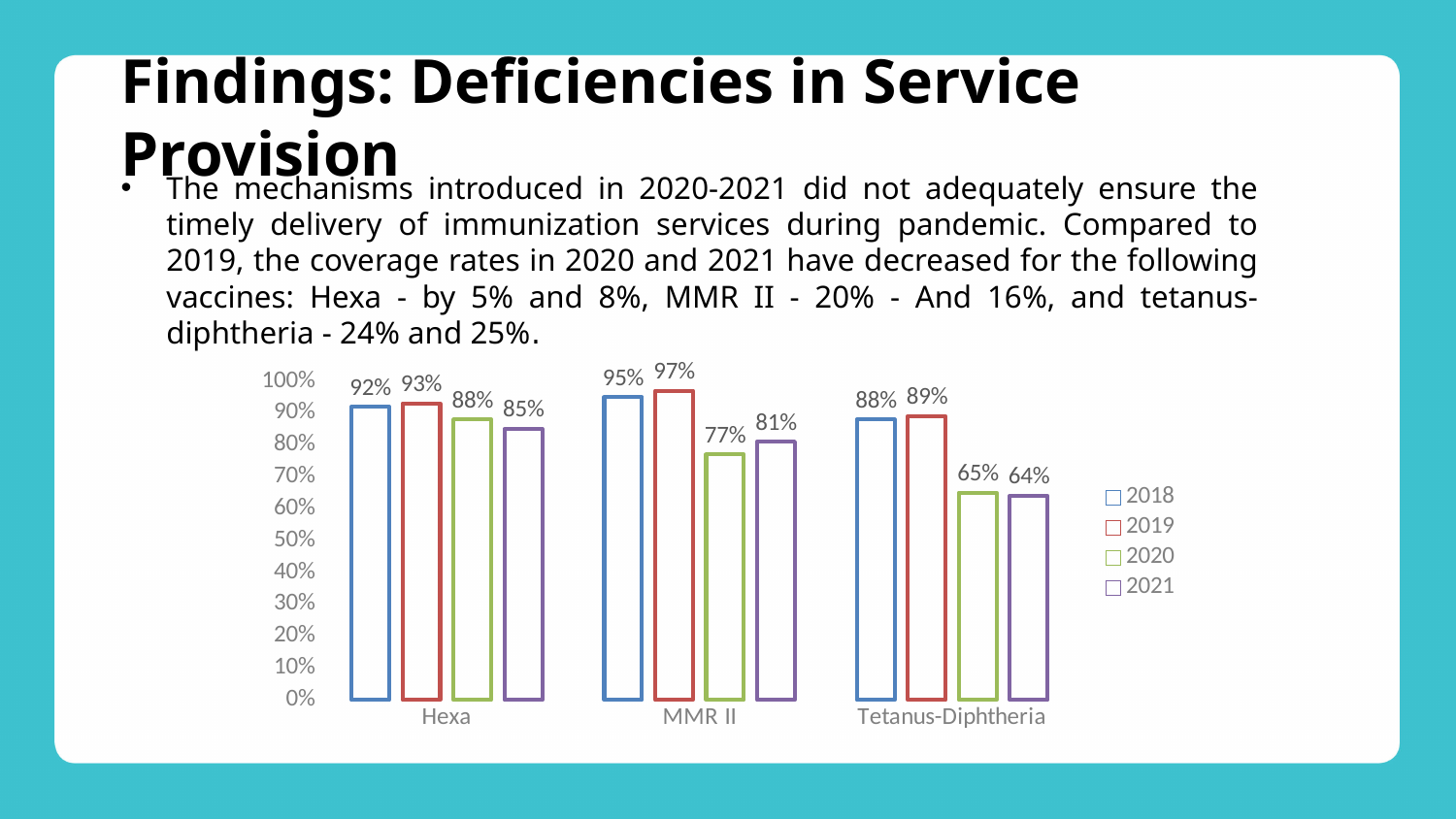
Does the coverage rate for MMR II rise or fall from 2019 to 2021? Fall Which is larger, the 2021 coverage rate for Hexa or for MMR II? Hexa Which vaccine has the highest coverage rate in 2019? MMR II Which vaccine has the lowest coverage rate in 2020? Tetanus-Diphtheria Which years are listed in the chart legend? 2018, 2019, 2020, 2021 How many series does the legend list? 4 What is the coverage rate for MMR II in 2020? 77% What is the coverage rate for Tetanus-Diphtheria in 2021? 64% What is the difference between the 2019 and 2021 coverage rates for Tetanus-Diphtheria? 25% What kind of chart is shown on the slide? Bar chart What is the coverage rate for Hexa in 2018? 92% How many vaccine categories are shown on the x axis? 3